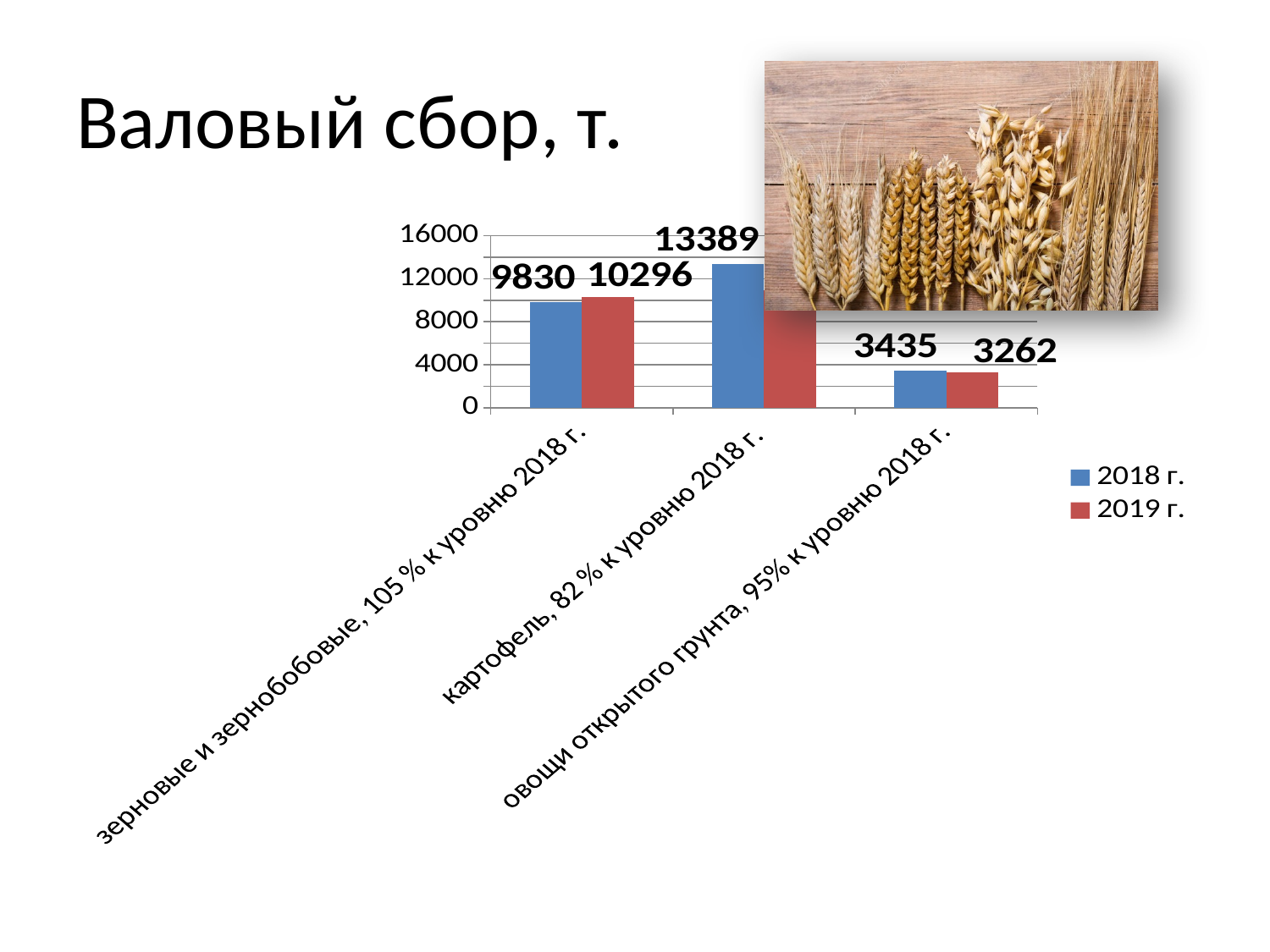
What is the 2018 г. value for овощи открытого грунта? 3435 What is the 2018 г. value for картофель? 13389 Which is larger for овощи открытого грунта: the 2018 г. value or the 2019 г. value? 2018 г. How many series does the legend list? 2 Which category has the lowest 2018 г. value? овощи открытого грунта Is the 2019 г. value for картофель greater or less than 4000? greater What is the 2019 г. value for зерновые и зернобобовые? 10296 Which category has the highest 2018 г. value? картофель What kind of chart is shown on the slide? bar chart What is the 2019 г. value for овощи открытого грунта? 3262 What is the difference between the 2019 г. and 2018 г. values for зерновые и зернобобовые? 466 What is the 2018 г. value for зерновые и зернобобовые? 9830